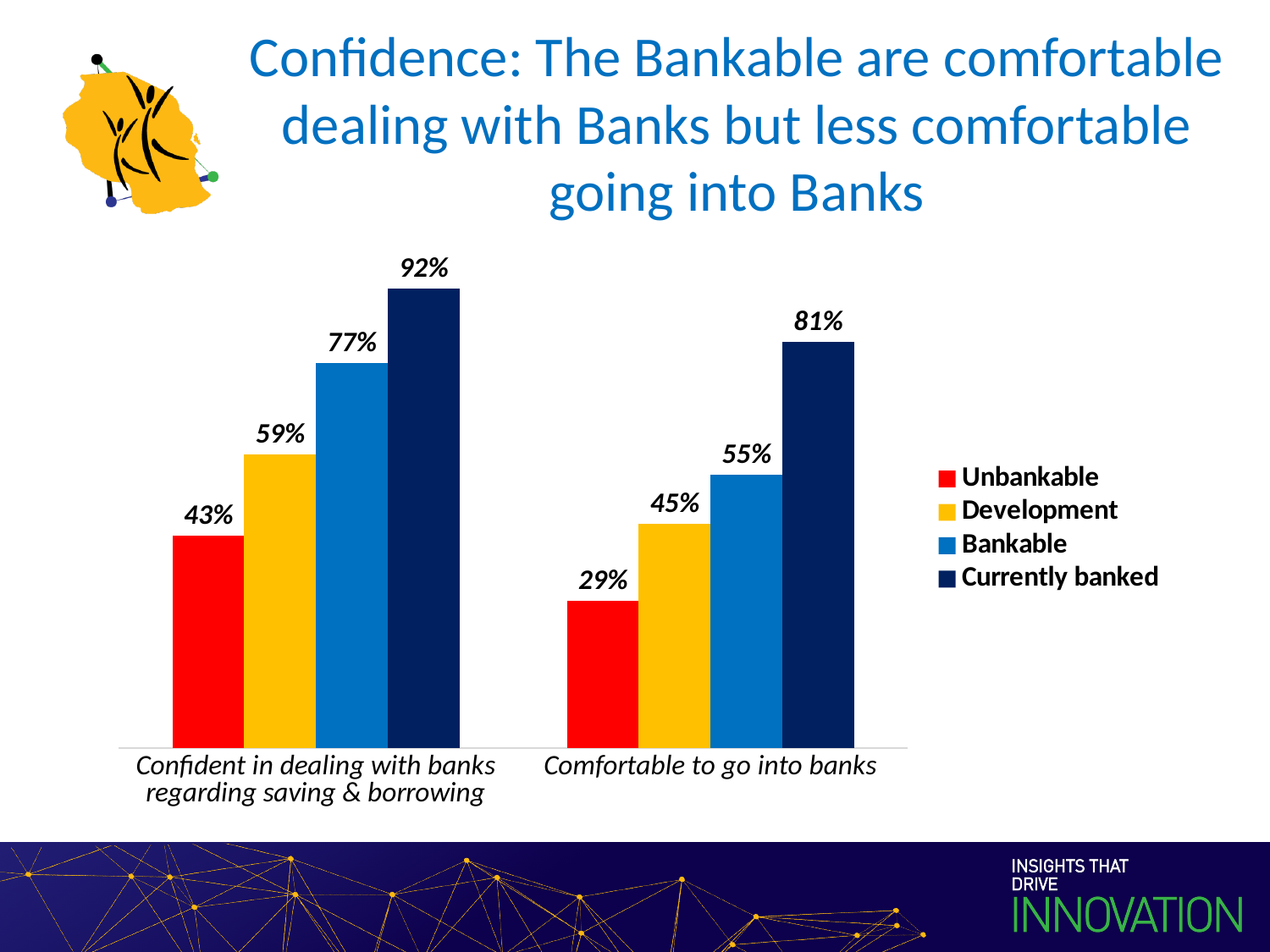
What is the difference between the Bankable and Unbankable values in the 'Comfortable to go into banks' category? 26% Which is larger: the Development value for 'Confident in dealing with banks regarding saving & borrowing' or the Bankable value for 'Comfortable to go into banks'? Development value for 'Confident in dealing with banks regarding saving & borrowing' What is the difference between the Currently banked values for 'Confident in dealing with banks regarding saving & borrowing' and 'Comfortable to go into banks'? 11% Which series has the lowest value in the 'Comfortable to go into banks' category? Unbankable What kind of chart is shown on the slide? Bar chart How many series does the legend list? 4 How many categories are shown on the x axis of the chart? 2 What is the value for Unbankable in the 'Comfortable to go into banks' category? 29% What colour represents the Currently banked series in the chart? Dark navy blue What is the value for Development in the 'Comfortable to go into banks' category? 45% What is the value for Bankable in the 'Confident in dealing with banks regarding saving & borrowing' category? 77% Which series has the highest value in the 'Confident in dealing with banks regarding saving & borrowing' category? Currently banked